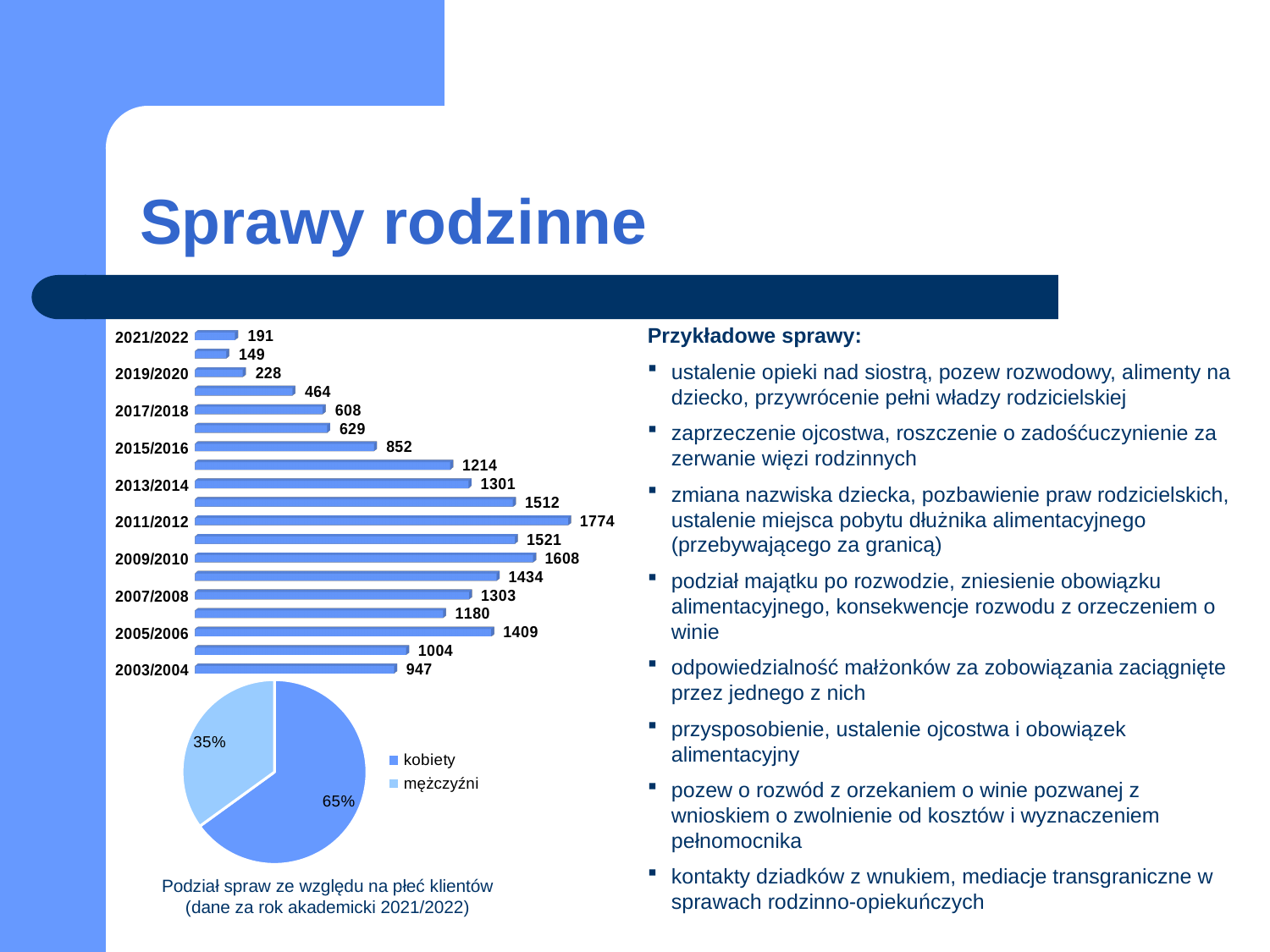
In the bar chart, which labelled academic year has the highest value? 2011/2012 In the bar chart, what is the difference between the values for 2009/2010 and 2007/2008? 305 In the bar chart, which is larger: the value for 2005/2006 or the value for 2013/2014? 2005/2006 In the bar chart, what is the value for 2015/2016? 852 In the bar chart, what is the value for 2003/2004? 947 How many entries does the legend of the pie chart list? 2 What type of chart is the chart at the top left of the slide? bar chart In the bar chart, what is the smallest value shown on any bar? 149 In the bar chart, what is the value for 2011/2012? 1774 How many bars are shown in the bar chart? 19 In the bar chart, what is the value for 2021/2022? 191 In the pie chart, what share of cases is for kobiety? 65%